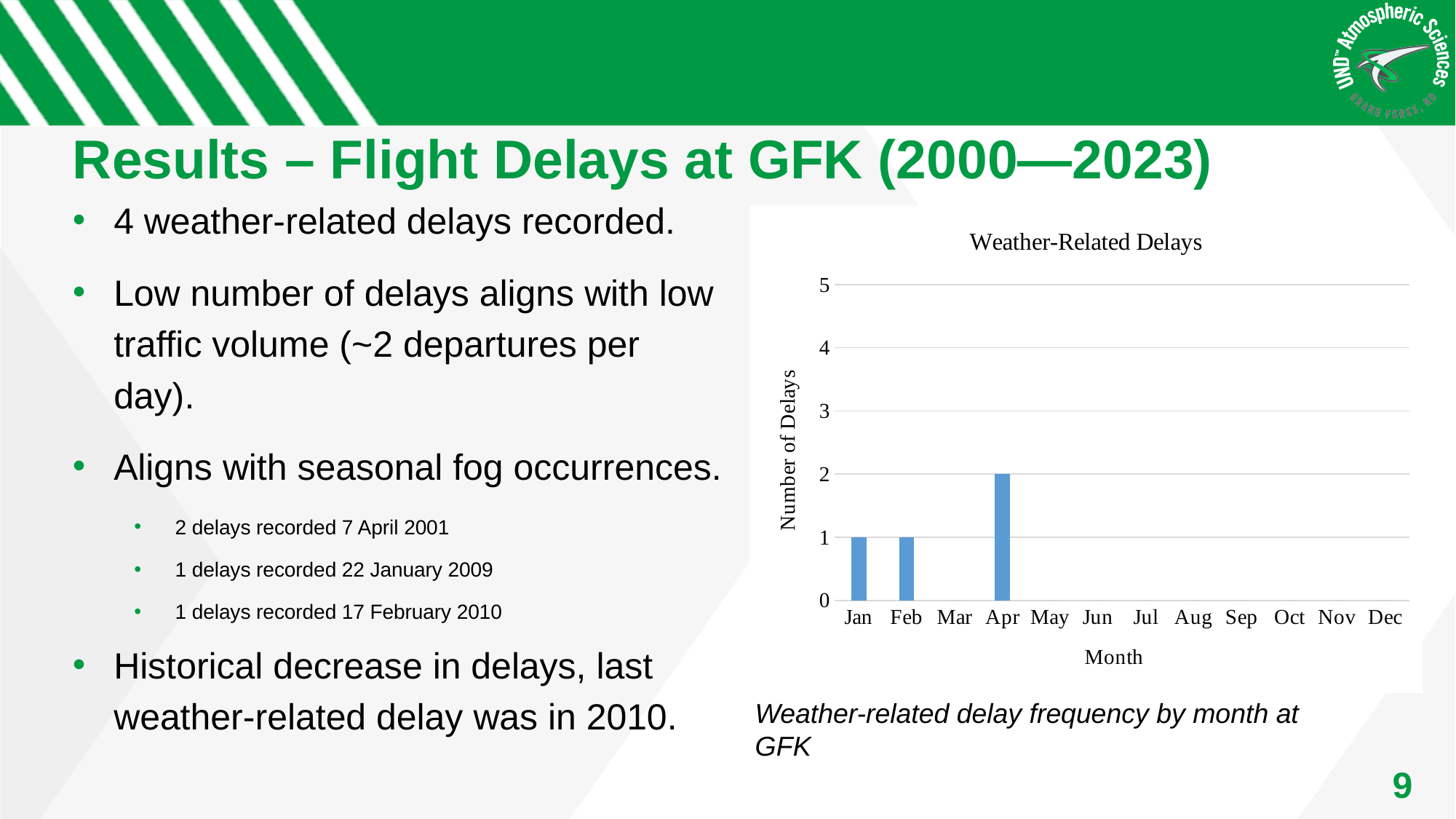
What is the label of the y axis of the chart? Number of Delays How many weather-related delays are shown for Apr? 2 How many weather-related delays are shown for Jan? 1 How many weather-related delays are shown for Feb? 1 How many weather-related delays are shown for Jul? 0 Which month has more weather-related delays, Feb or Apr? Apr What is the title of the chart? Weather-Related Delays How many months are shown on the x axis of the chart? 12 What is the difference between the number of delays in Apr and in Jan? 1 How many months have a non-zero number of weather-related delays? 3 Which month has the highest number of weather-related delays? Apr What kind of chart is shown on the slide? bar chart